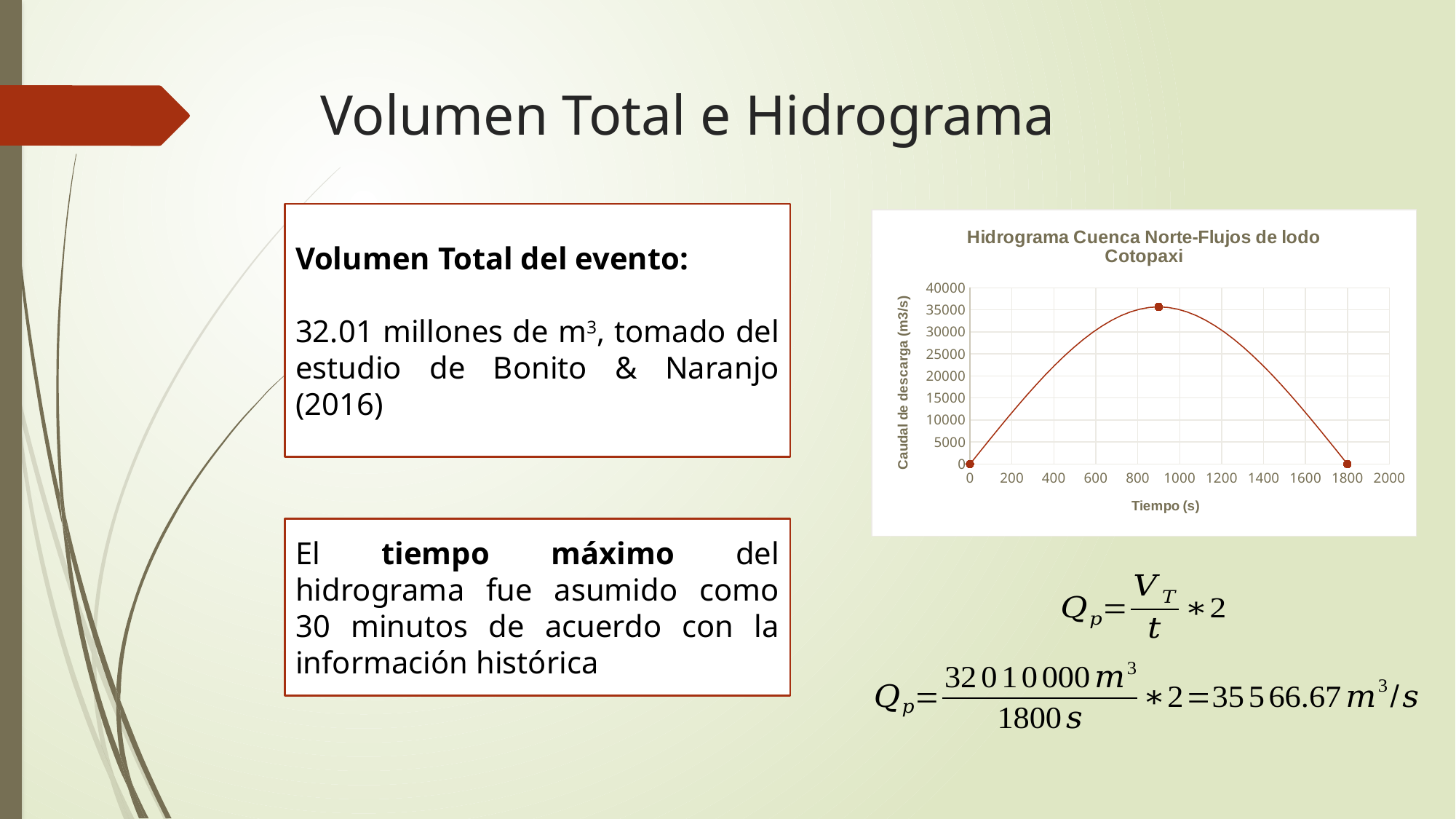
What is the discharge value at time 0 s? 0 Does the discharge rise or fall along the x axis between 1000 s and 1800 s? fall What kind of chart is shown on the slide? line chart What is the discharge value at time 1800 s? 0 Is the peak discharge value greater or less than 30000? greater Is the time at which the peak discharge occurs greater or less than 1000 s? less What is the title of the chart? Hidrograma Cuenca Norte-Flujos de lodo Cotopaxi How many data points are marked on the curve? 3 Does the discharge rise or fall along the x axis between 0 s and 800 s? rise What is the label of the y axis of the chart? Caudal de descarga (m3/s) Which is larger, the discharge at 400 s or the discharge at 1600 s? 400 s Is the peak discharge value greater or less than 40000? less